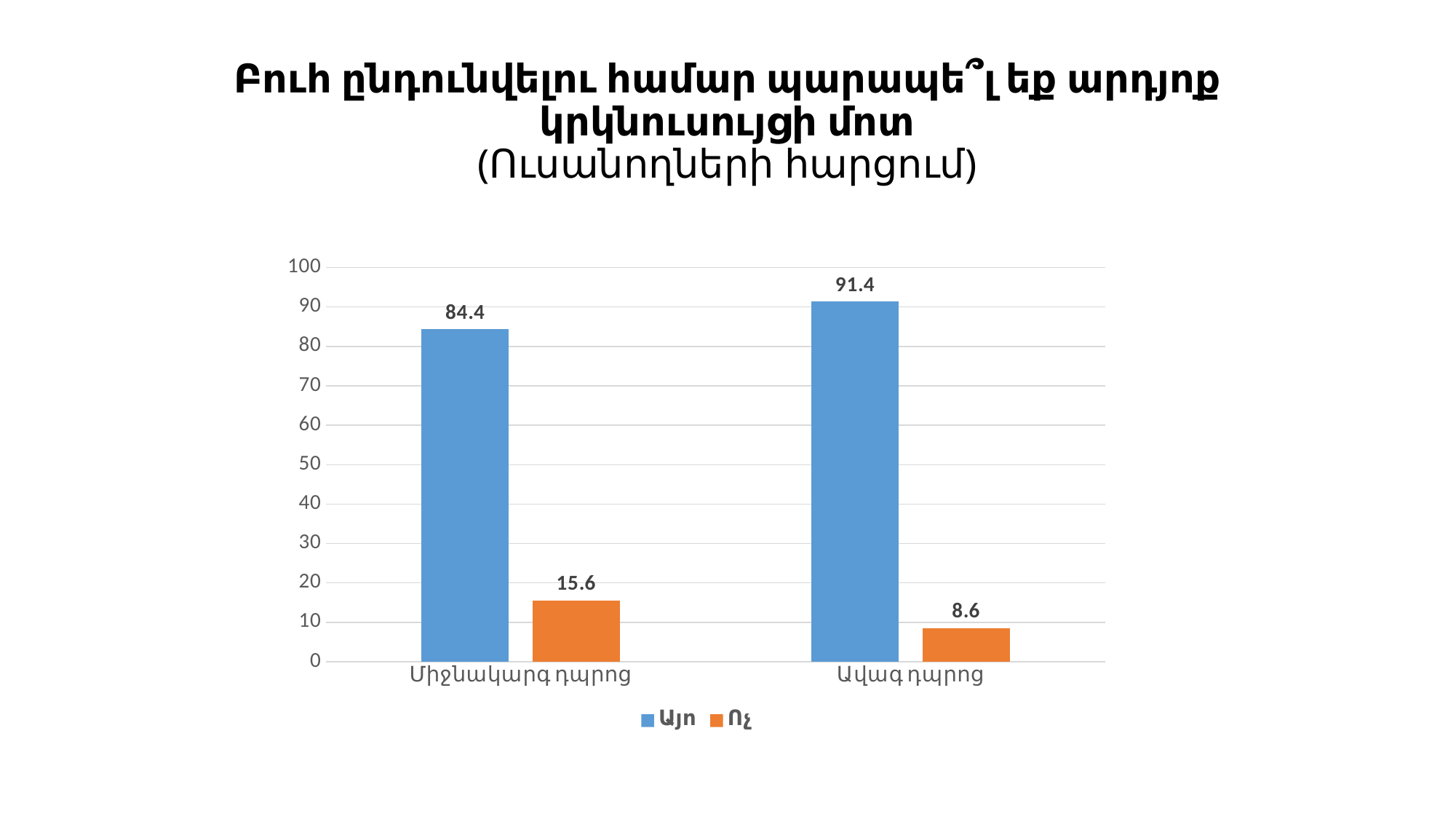
How many series does the legend list? 2 What kind of chart is shown on the slide? bar chart What is the value for "Ոչ" in the "Միջնակարգ դպրոց" category? 15.6 Which category has the lowest value for the "Ոչ" series? Ավագ դպրոց How many categories are shown on the x axis? 2 What is the value for "Այո" in the "Միջնակարգ դպրոց" category? 84.4 Which is larger: the "Ոչ" value for "Միջնակարգ դպրոց" or for "Ավագ դպրոց"? Միջնակարգ դպրոց What is the difference between the "Այո" values for "Ավագ դպրոց" and "Միջնակարգ դպրոց"? 7 Which colour represents the "Ոչ" series? orange Is the "Այո" value for "Ավագ դպրոց" greater or less than 90? greater Which category has the highest value for the "Այո" series? Ավագ դպրոց What is the value for "Ոչ" in the "Ավագ դպրոց" category? 8.6